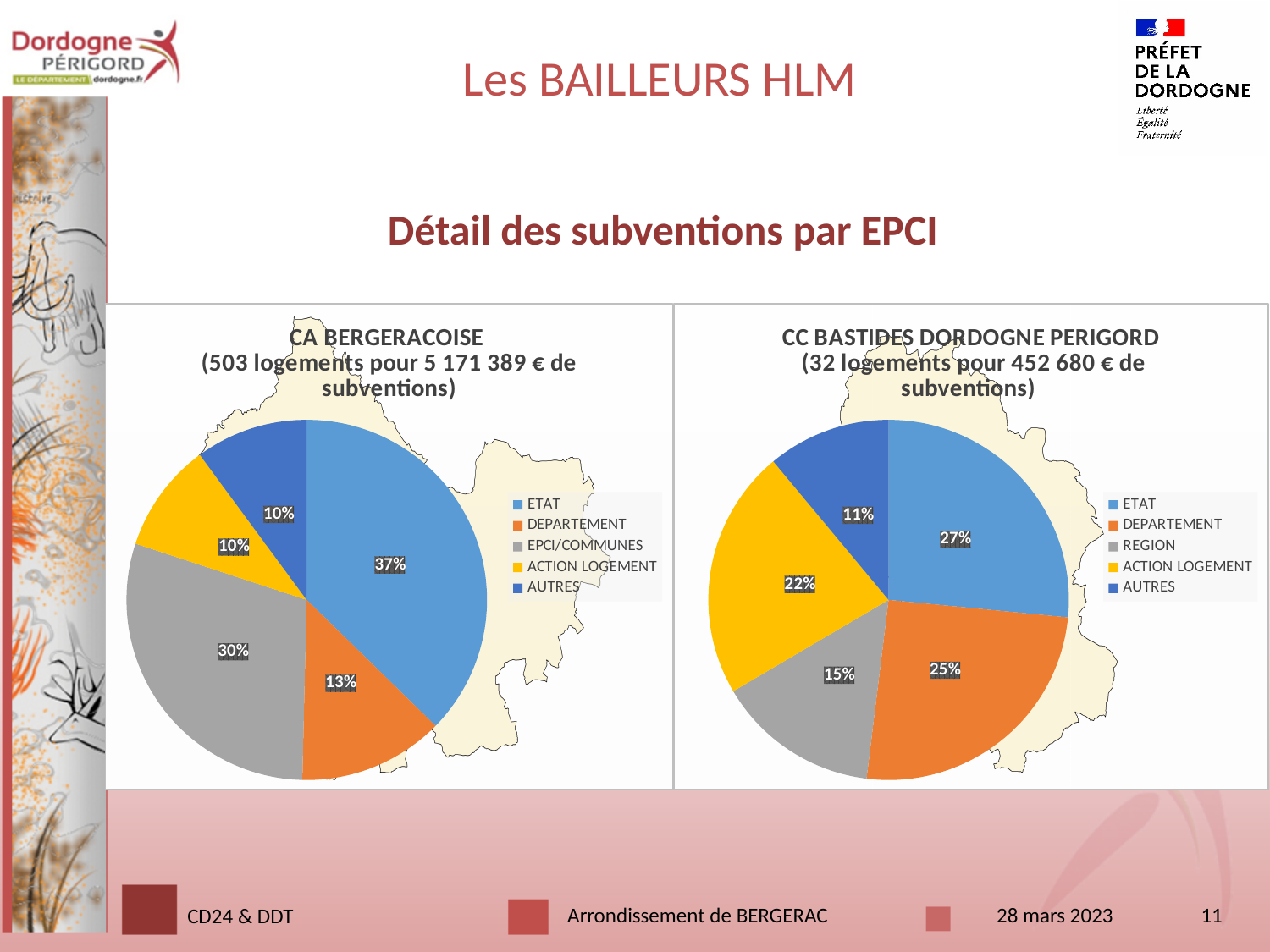
In the CC BASTIDES DORDOGNE PERIGORD pie chart, which category has the smallest share? AUTRES In the CA BERGERACOISE pie chart, which category has the largest share? ETAT In the CC BASTIDES DORDOGNE PERIGORD pie chart, what is the difference in percentage points between the ETAT share and the DEPARTEMENT share? 2 In the CA BERGERACOISE pie chart, how many slices does the pie have? 5 In the CC BASTIDES DORDOGNE PERIGORD pie chart, what share of subsidies comes from ACTION LOGEMENT? 22% In the CA BERGERACOISE pie chart, what share is attributed to EPCI/COMMUNES? 30% What type of chart is used on the left side of the slide for CA BERGERACOISE? Pie chart In the CA BERGERACOISE pie chart, what share of subsidies comes from ETAT? 37% In the CC BASTIDES DORDOGNE PERIGORD pie chart, which is larger, the share for ACTION LOGEMENT or the share for REGION? ACTION LOGEMENT How many entries does the legend of the CC BASTIDES DORDOGNE PERIGORD chart list? 5